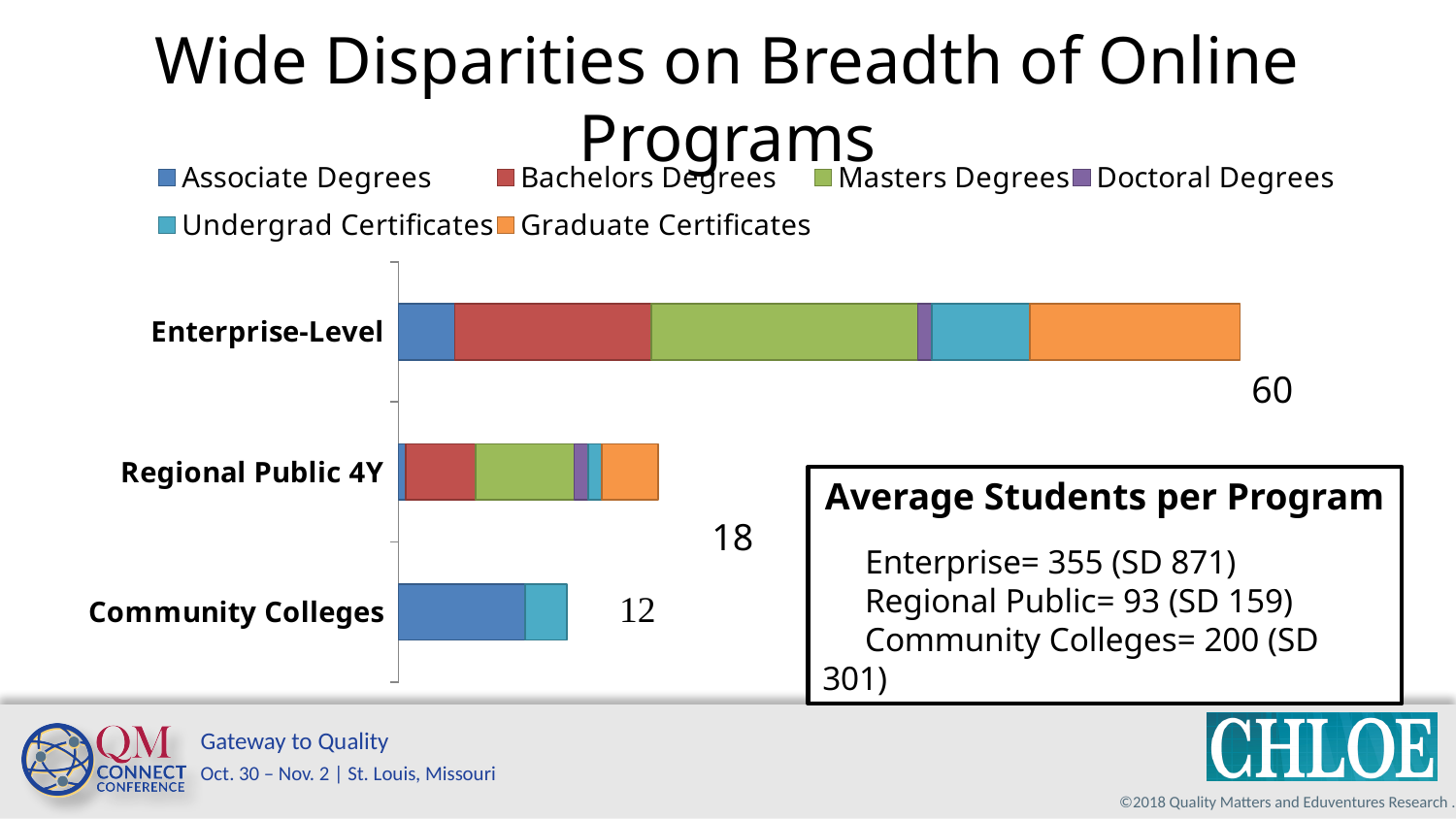
Which has a larger total, Regional Public 4Y or Community Colleges? Regional Public 4Y Which category has the lowest total on the chart? Community Colleges Which category has the highest total on the chart? Enterprise-Level What is the difference between the total for Enterprise-Level and the total for Regional Public 4Y? 42 How many series does the chart legend list? 6 What is the total value of the stacked bar for Enterprise-Level? 60 Which two series appear in the Community Colleges bar? Associate Degrees and Undergrad Certificates What kind of chart is shown on the slide? Stacked bar chart What is the total value of the stacked bar for Regional Public 4Y? 18 What is the difference between the total for Regional Public 4Y and the total for Community Colleges? 6 How many institution categories are plotted on the chart? 3 What is the total value of the stacked bar for Community Colleges? 12